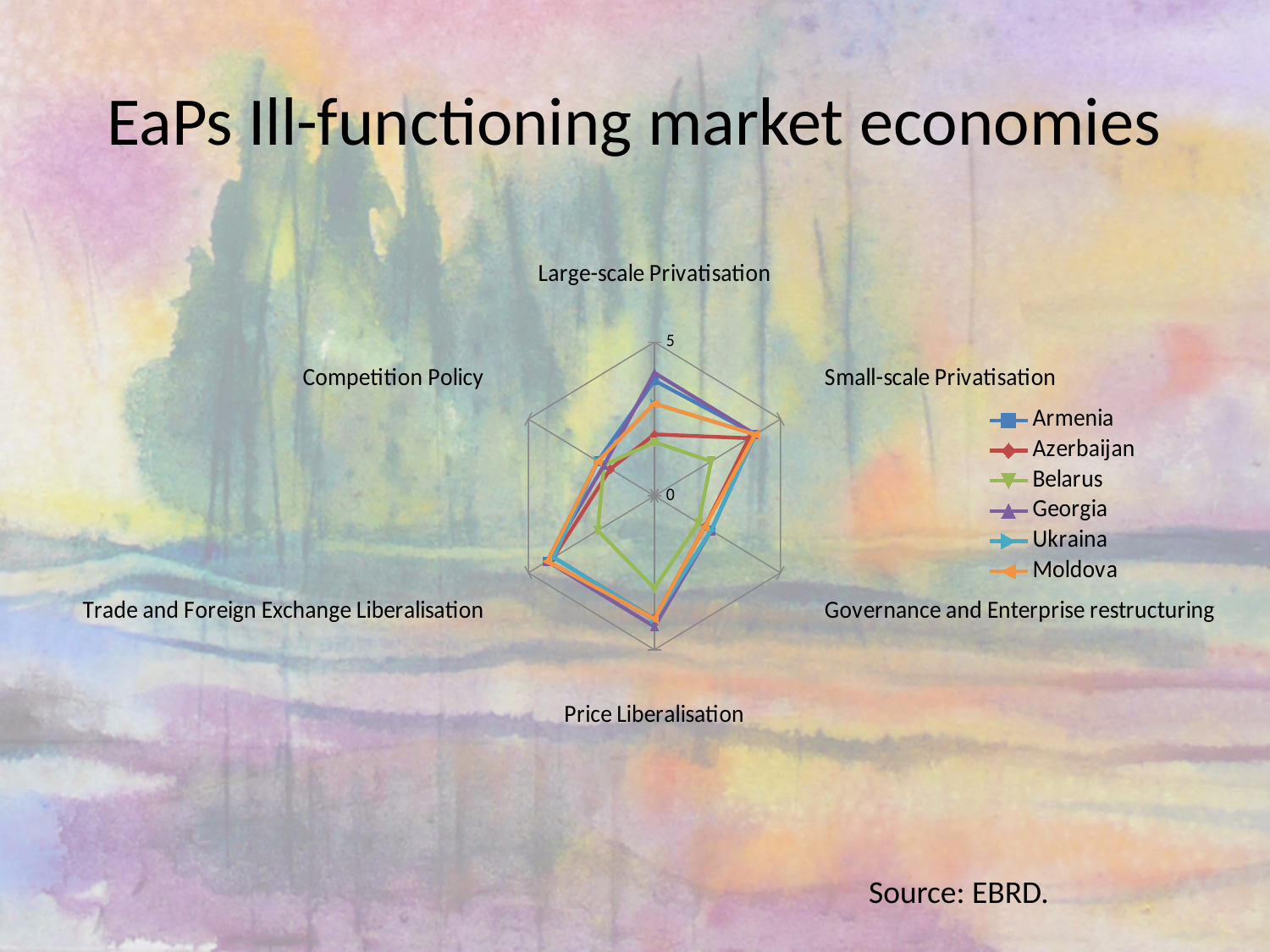
Which country has the lowest value for Small-scale Privatisation? Belarus What is the title of the slide containing the chart? EaPs Ill-functioning market economies Is Belarus's value for Large-scale Privatisation greater or less than 5? less Which country has the lowest value for Large-scale Privatisation? Belarus Which is larger, Moldova's or Belarus's value for Competition Policy? Moldova Which is larger, Georgia's or Belarus's value for Price Liberalisation? Georgia How many categories (axes) does the radar chart have? 6 How many series does the legend list? 6 Which country has the lowest value for Price Liberalisation? Belarus What source is cited for the chart data? EBRD What kind of chart is shown on the slide? Radar chart